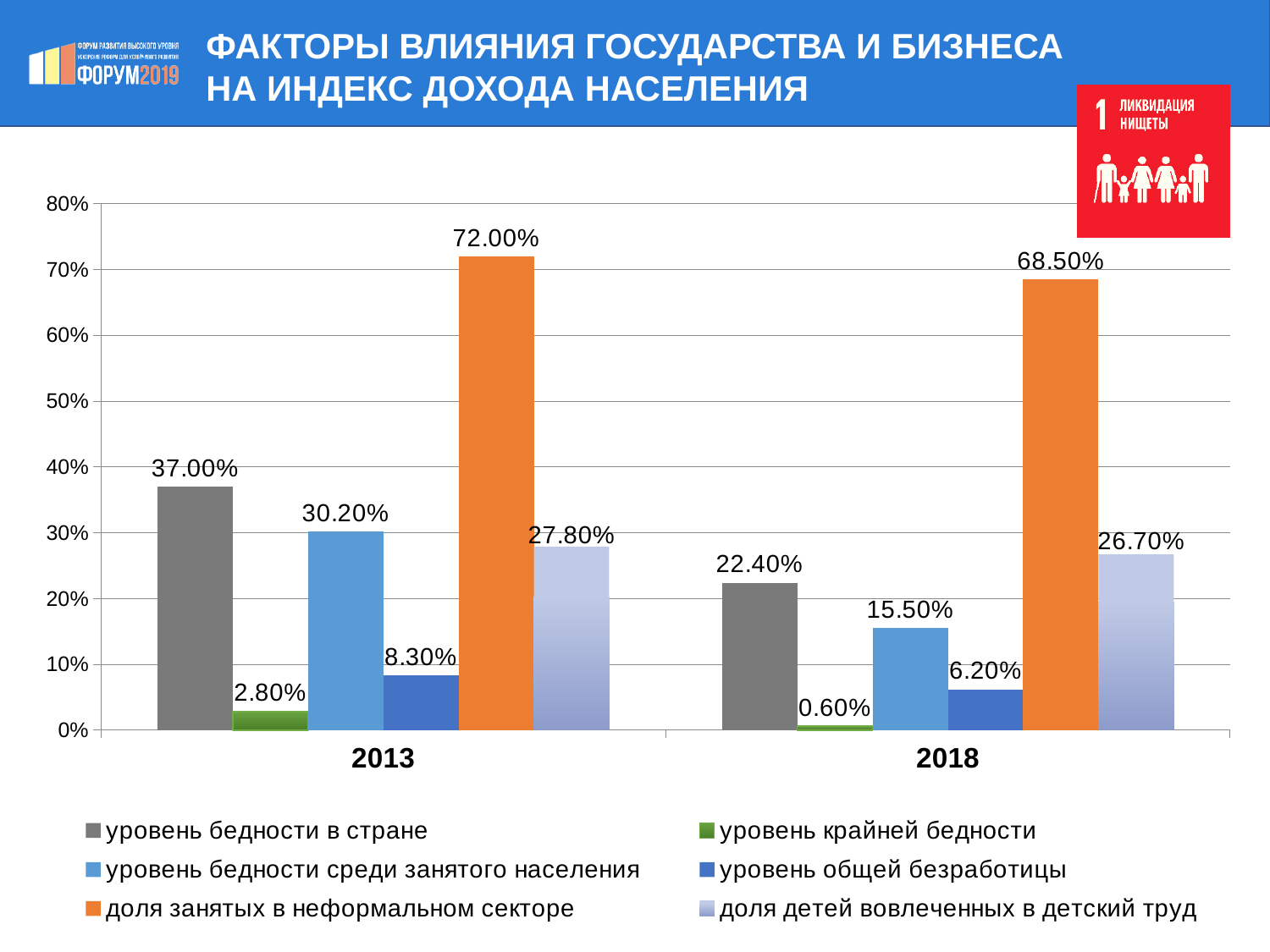
What is the value for 'уровень бедности в стране' in 2013? 37.00% What kind of chart is shown on the slide? bar chart How many series does the legend list? 6 Which series has the highest value in 2013? доля занятых в неформальном секторе What is the value for 'уровень общей безработицы' in 2013? 8.30% Does the value for 'уровень бедности в стране' rise or fall from 2013 to 2018? fall What is the value for 'доля занятых в неформальном секторе' in 2018? 68.50% How many categories are shown on the x axis? 2 Which is larger: 'доля детей вовлеченных в детский труд' in 2013 or in 2018? 2013 What is the value for 'уровень крайней бедности' in 2018? 0.60% What is the difference between the 2013 and 2018 values for 'уровень бедности среди занятого населения'? 14.70% Which series has the lowest value in 2018? уровень крайней бедности